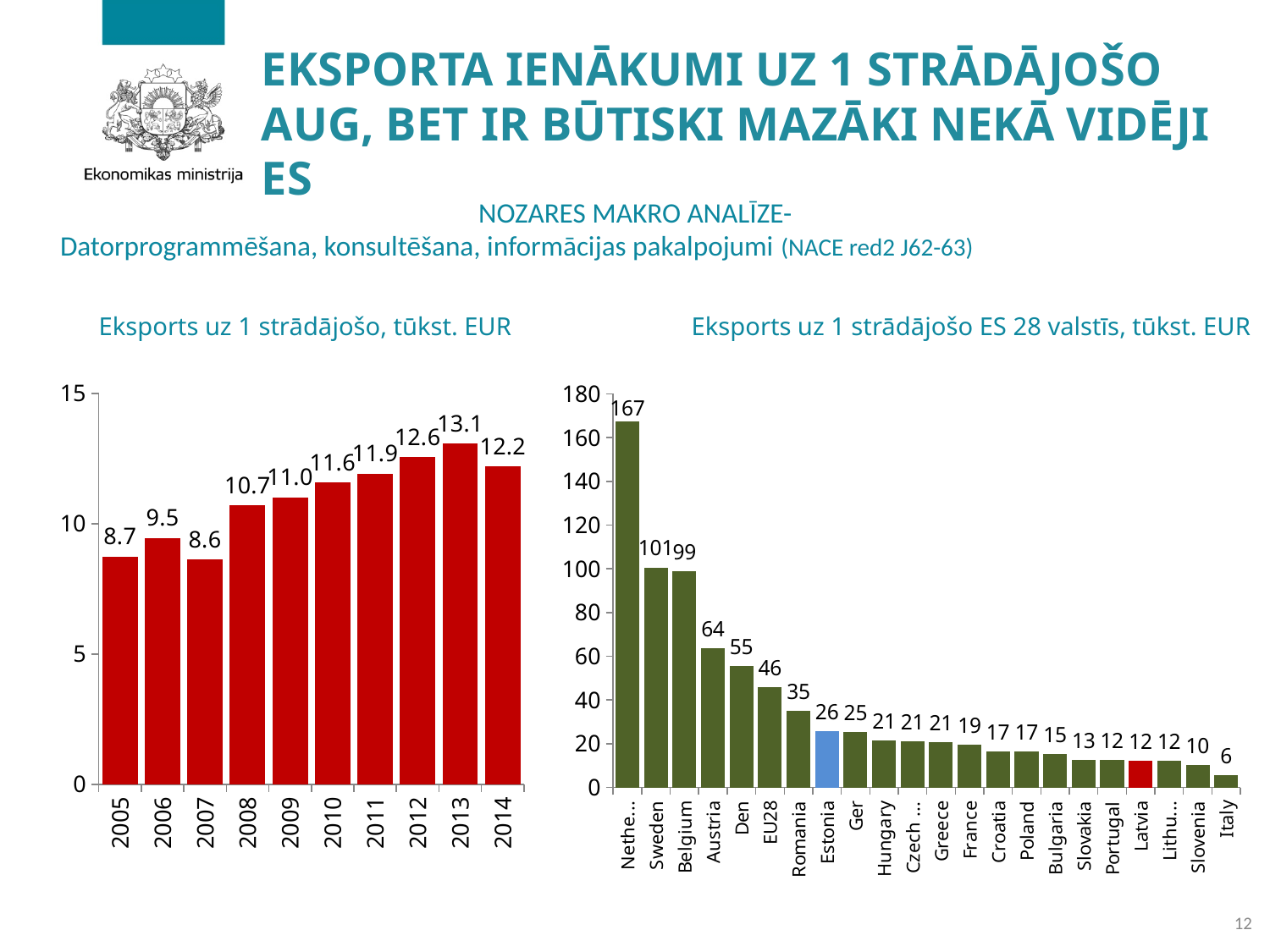
In the left chart 'Eksports uz 1 strādājošo, tūkst. EUR', how many years are shown? 10 What type of chart is the right chart 'Eksports uz 1 strādājošo ES 28 valstīs, tūkst. EUR'? bar chart In the right chart 'Eksports uz 1 strādājošo ES 28 valstīs, tūkst. EUR', what is the difference between the values for Sweden and Belgium? 2 In the right chart 'Eksports uz 1 strādājošo ES 28 valstīs, tūkst. EUR', which country has the lowest value? Italy In the left chart 'Eksports uz 1 strādājošo, tūkst. EUR', what is the value for 2013? 13.1 In the left chart 'Eksports uz 1 strādājošo, tūkst. EUR', which year has the lowest value? 2007 In the left chart 'Eksports uz 1 strādājošo, tūkst. EUR', do the values generally rise or fall from 2005 to 2013? rise In the right chart 'Eksports uz 1 strādājošo ES 28 valstīs, tūkst. EUR', which is larger, the value for Estonia or the value for Latvia? Estonia In the left chart 'Eksports uz 1 strādājošo, tūkst. EUR', which year has the highest value? 2013 In the left chart 'Eksports uz 1 strādājošo, tūkst. EUR', what is the difference between the values for 2014 and 2005? 3.5 In the right chart 'Eksports uz 1 strādājošo ES 28 valstīs, tūkst. EUR', what is the value for Latvia? 12 In the right chart 'Eksports uz 1 strādājošo ES 28 valstīs, tūkst. EUR', what is the value for EU28? 46